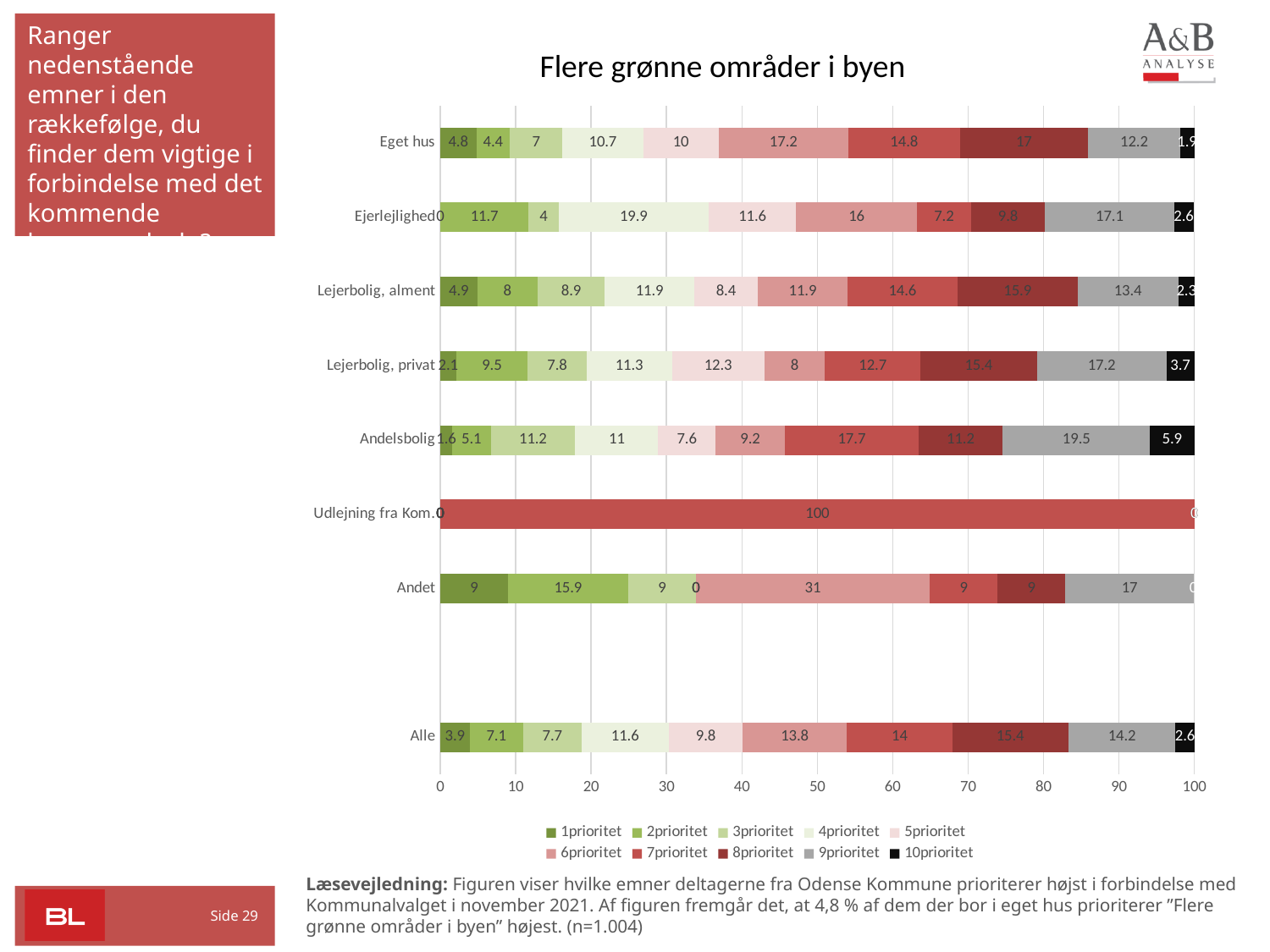
What is the value of 4prioritet for Ejerlejlighed? 19.9 What is the value of 9prioritet for Andelsbolig? 19.5 What is the value of 1prioritet for Eget hus? 4.8 What is the value of 6prioritet for Udlejning fra Kom.? 0 Which is larger: the 2prioritet value for Ejerlejlighed or for Lejerbolig, privat? Ejerlejlighed How many series does the legend list? 10 What kind of chart is shown on the slide? Stacked bar chart What is the value of 8prioritet for Alle? 15.4 Which category has the lowest value for 1prioritet among Eget hus, Lejerbolig, alment, Lejerbolig, privat and Andelsbolig? Andelsbolig How many categories are shown on the y axis? 8 What is the difference between the 9prioritet values for Lejerbolig, privat and Eget hus? 5 Which category has the highest value for 10prioritet? Andelsbolig